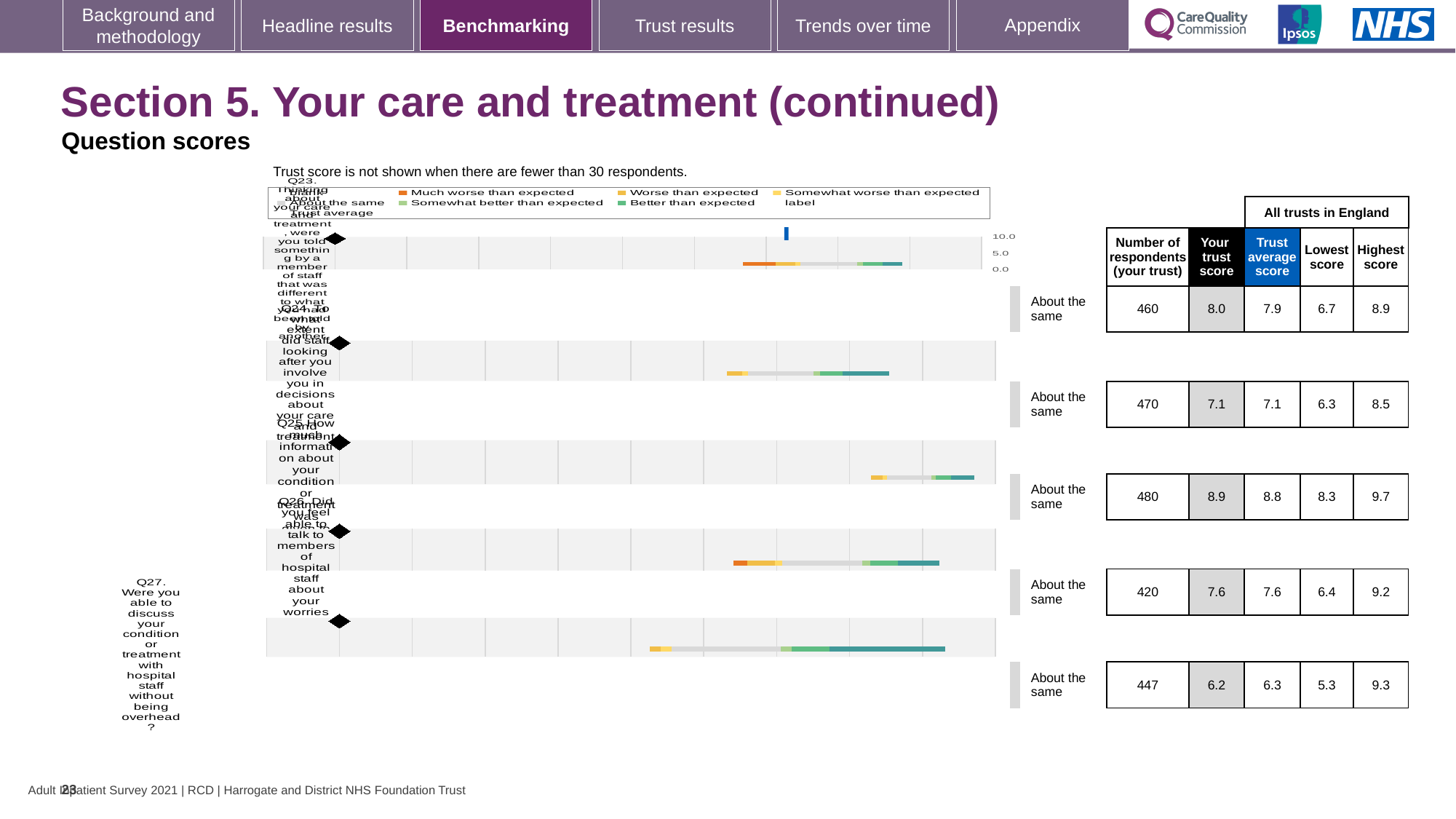
What kind of chart is used to show the question scores on this slide? bar chart Which question has the highest 'Your trust score'? Q25 Which question has the lowest 'Your trust score'? Q27 How many questions (Q23 to Q27) are plotted in the chart? 5 What benchmark label is shown next to the chart for Q24? About the same What is the 'Lowest score' for Q26? 6.4 What is the difference between the highest score and the lowest score for Q24? 2.2 What is the 'Trust average score' for Q25? 8.8 What is the 'Highest score' for Q25? 9.7 For Q23, which is larger: 'Your trust score' or 'Trust average score'? Your trust score What is the 'Your trust score' for Q23? 8.0 How many respondents (your trust) are shown for Q27? 447